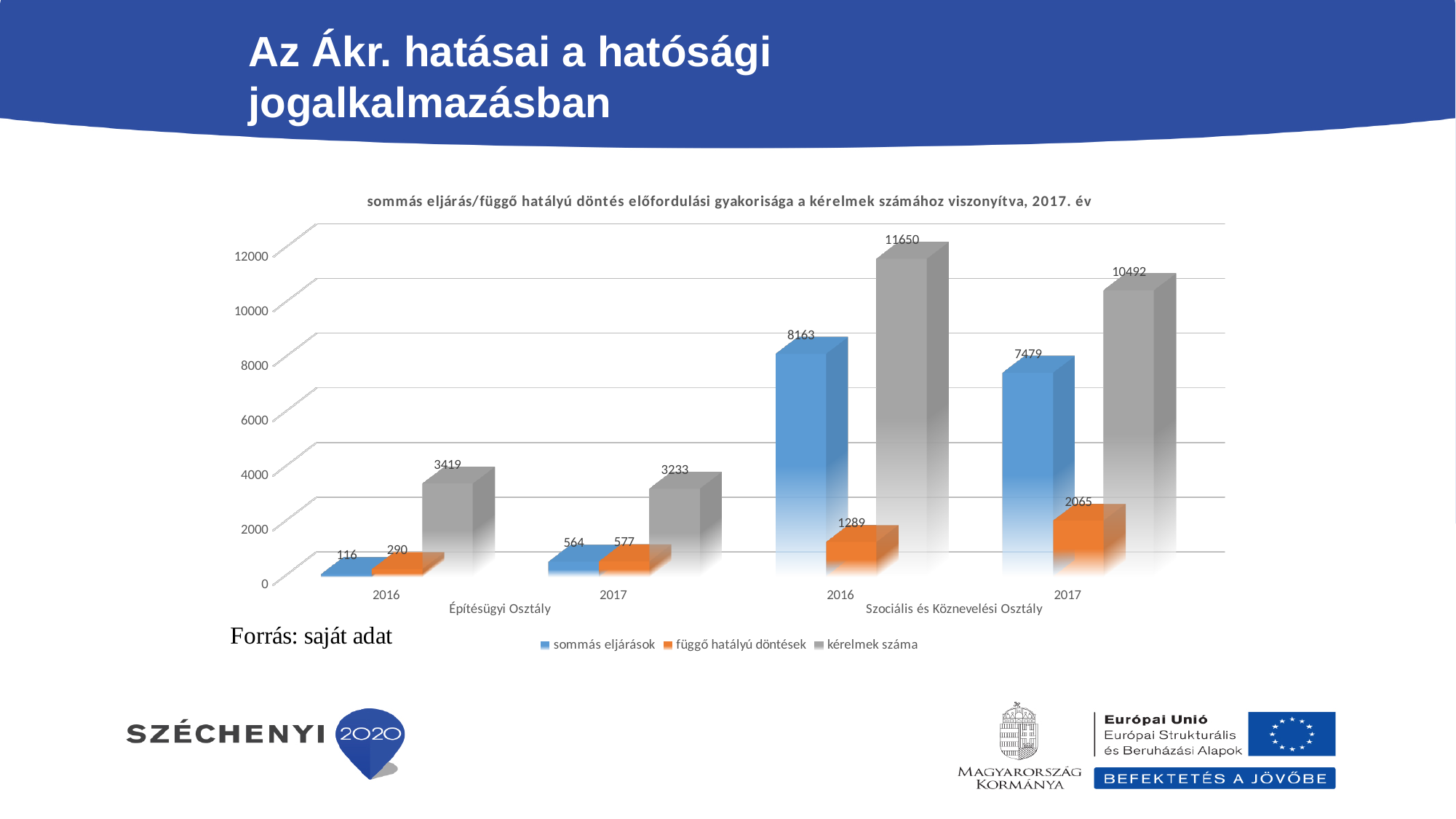
Is the value of kérelmek száma for Építésügyi Osztály in 2017 greater or less than 4000? less What is the value of függő hatályú döntések for Szociális és Köznevelési Osztály in 2017? 2065 Which is larger: sommás eljárások for Szociális és Köznevelési Osztály in 2016 or in 2017? 2016 Which category has the highest value for kérelmek száma? Szociális és Köznevelési Osztály 2016 How many category groups are shown on the x axis? 4 What is the value of sommás eljárások for Építésügyi Osztály in 2016? 116 How many series does the legend list? 3 What is the value of kérelmek száma for Szociális és Köznevelési Osztály in 2016? 11650 What kind of chart is shown on the slide? bar chart Which colour represents függő hatályú döntések in the legend? orange What is the difference between kérelmek száma for Szociális és Köznevelési Osztály in 2016 and in 2017? 1158 Which category has the lowest value for sommás eljárások? Építésügyi Osztály 2016